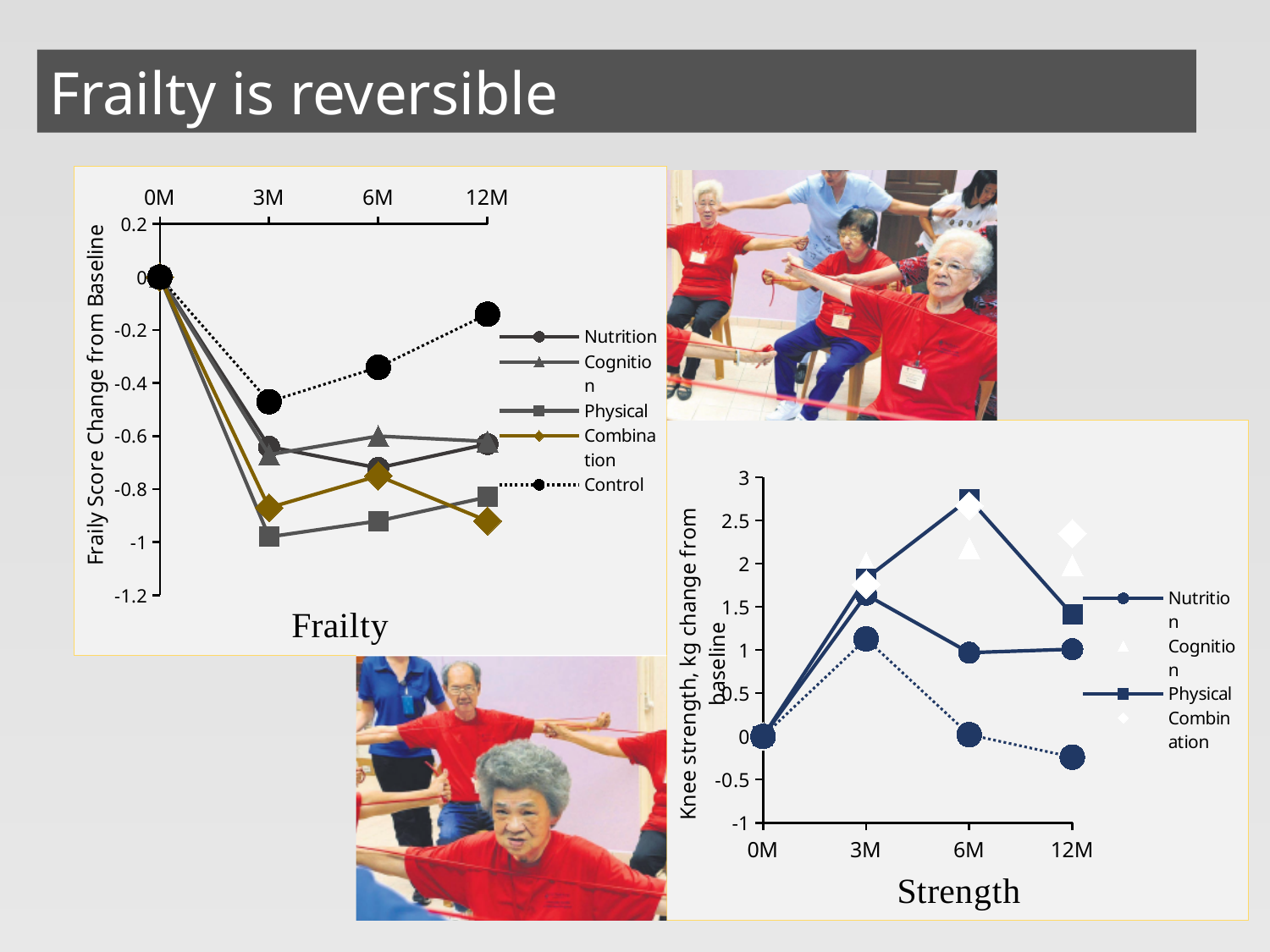
In the Frailty chart, is the Control value at 3M greater or less than -0.6? greater How many series does the legend of the Frailty chart list? 5 What kind of chart is the Frailty chart? line chart In the Frailty chart, which series has the highest value at 12M? Control In the Strength chart, is the Physical value at 6M greater or less than 2.5? greater In the Frailty chart, which series has the lowest value at 3M? Physical In the Frailty chart, is the Physical value at 3M greater or less than -0.8? less How many series does the legend of the Strength chart list? 4 In the Frailty chart, does the Control series rise or fall from 3M to 12M? rise In the Strength chart, does the Physical series rise or fall from 6M to 12M? fall In the Strength chart, which series has the highest value at 6M? Physical How many time points are shown on the x axis of the Strength chart? 4